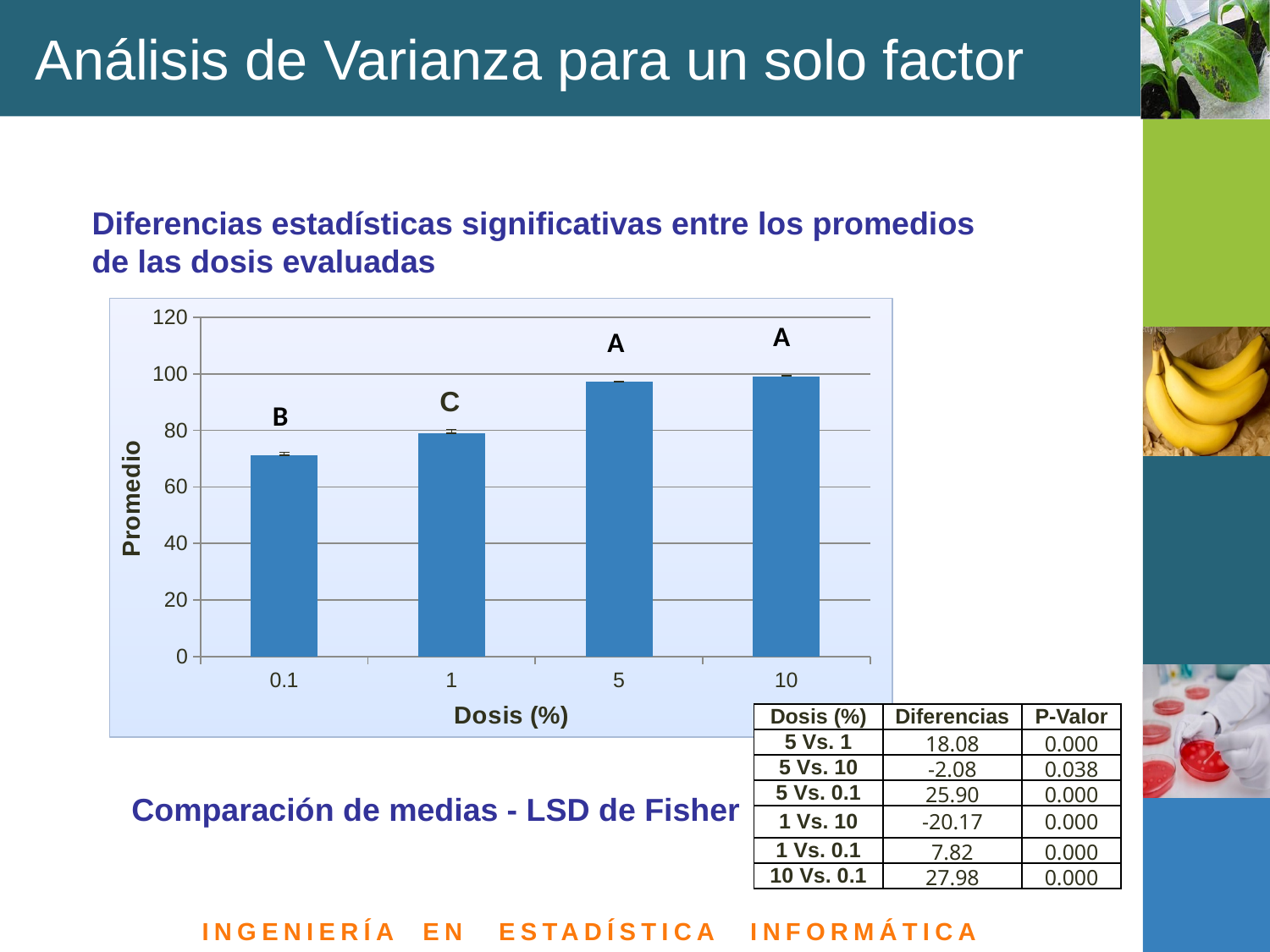
How many dose categories are plotted on the x axis of the chart? 4 Which has a higher Promedio, dose 0.1 or dose 1? 1 Which has a higher Promedio, dose 1 or dose 5? 5 Do the Promedio values rise or fall as the dose increases along the x axis? rise What letter is printed above the bar for dose 0.1? B What kind of chart is shown on the slide? bar chart Is the Promedio for dose 10 greater or less than 80? greater What is the title of the y axis of the chart? Promedio Is the Promedio for dose 1 greater or less than 60? greater Is the Promedio for dose 0.1 greater or less than 80? less Which dose (%) has the lowest Promedio in the chart? 0.1